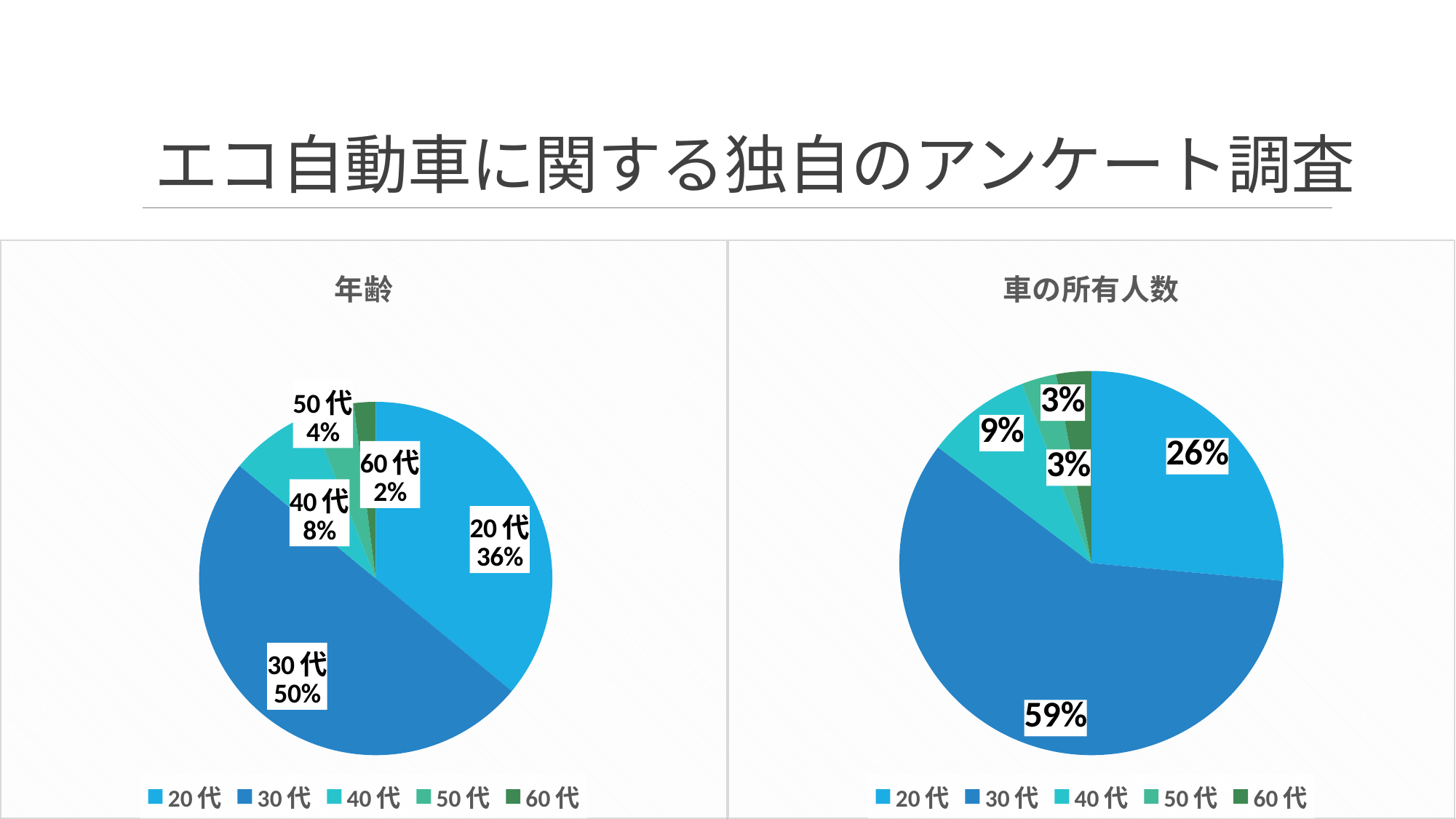
In the 年齢 pie chart, which age group has the largest share? 30代 In the 年齢 pie chart, what is the difference between the shares of 20代 and 40代? 28% In the 車の所有人数 pie chart, which age group has the largest share? 30代 How many slices does the 年齢 pie chart have? 5 In the 車の所有人数 pie chart, what percentage is shown for 30代? 59% In the 車の所有人数 pie chart, what is the difference between the shares of 30代 and 20代? 33% In the 年齢 pie chart, which age group has the smallest share? 60代 What type of chart is used for 車の所有人数? Pie chart In the 車の所有人数 pie chart, what percentage is shown for 40代? 9% In the 年齢 pie chart, which is larger, the share of 40代 or the share of 50代? 40代 In the 年齢 pie chart, what percentage is shown for 30代? 50% In the 年齢 pie chart, what percentage is shown for 50代? 4%